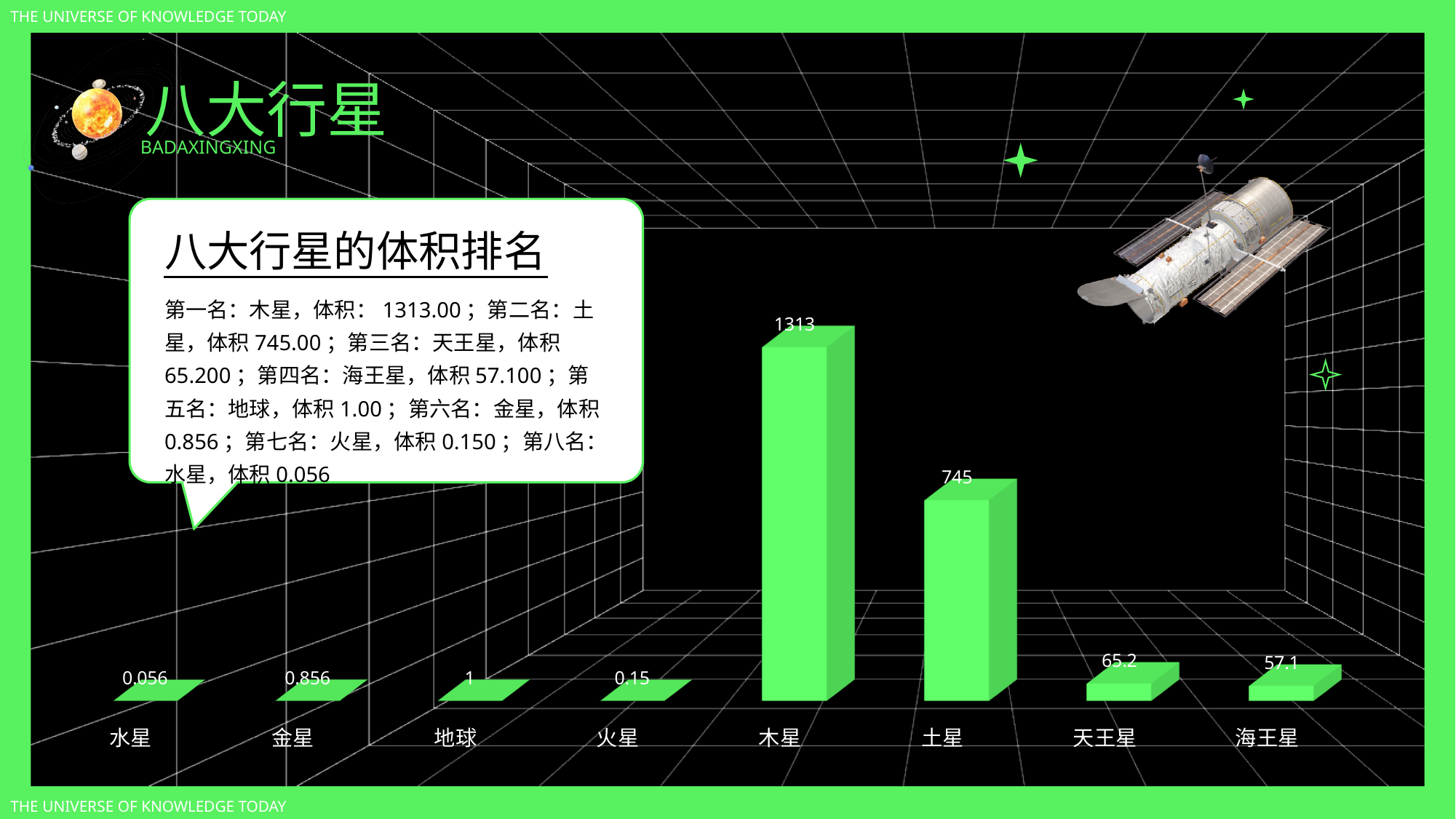
Which planet has the lowest value in the chart? 水星 What is the value shown for 木星 in the chart? 1313 Which planet has the highest value in the chart? 木星 What is the value shown for 金星 in the chart? 0.856 What is the value shown for 水星 in the chart? 0.056 What is the value shown for 天王星 in the chart? 65.2 What kind of chart is shown on the slide? Bar chart Which has a larger value, 地球 or 火星? 地球 What is the difference between the values for 天王星 and 海王星? 8.1 What is the difference between the values for 木星 and 土星? 568 What is the value shown for 土星 in the chart? 745 How many planets are shown as categories in the chart? 8